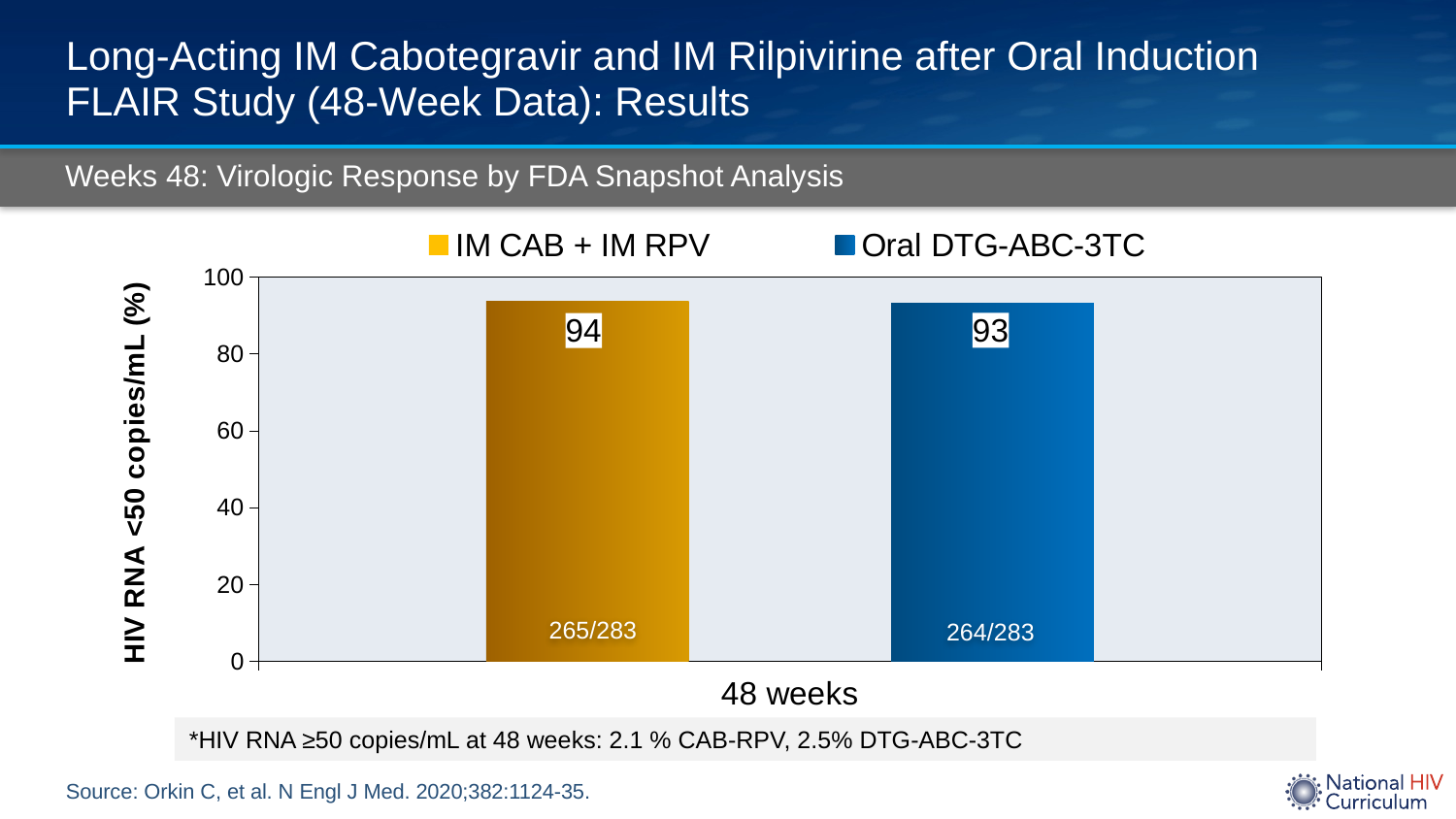
What is the difference between the IM CAB + IM RPV value and the Oral DTG-ABC-3TC value? 1 What is the y-axis label of the chart? HIV RNA <50 copies/mL (%) What is the value for Oral DTG-ABC-3TC at 48 weeks? 93 What kind of chart is shown on the slide? Bar chart What is the value for IM CAB + IM RPV at 48 weeks? 94 What fraction is printed on the IM CAB + IM RPV bar? 265/283 What is the maximum value shown on the y axis? 100 What fraction is printed on the Oral DTG-ABC-3TC bar? 264/283 What is the label on the x axis of the chart? 48 weeks Is the value for Oral DTG-ABC-3TC greater or less than 80? greater Which series has the higher value, IM CAB + IM RPV or Oral DTG-ABC-3TC? IM CAB + IM RPV How many series does the legend list? 2